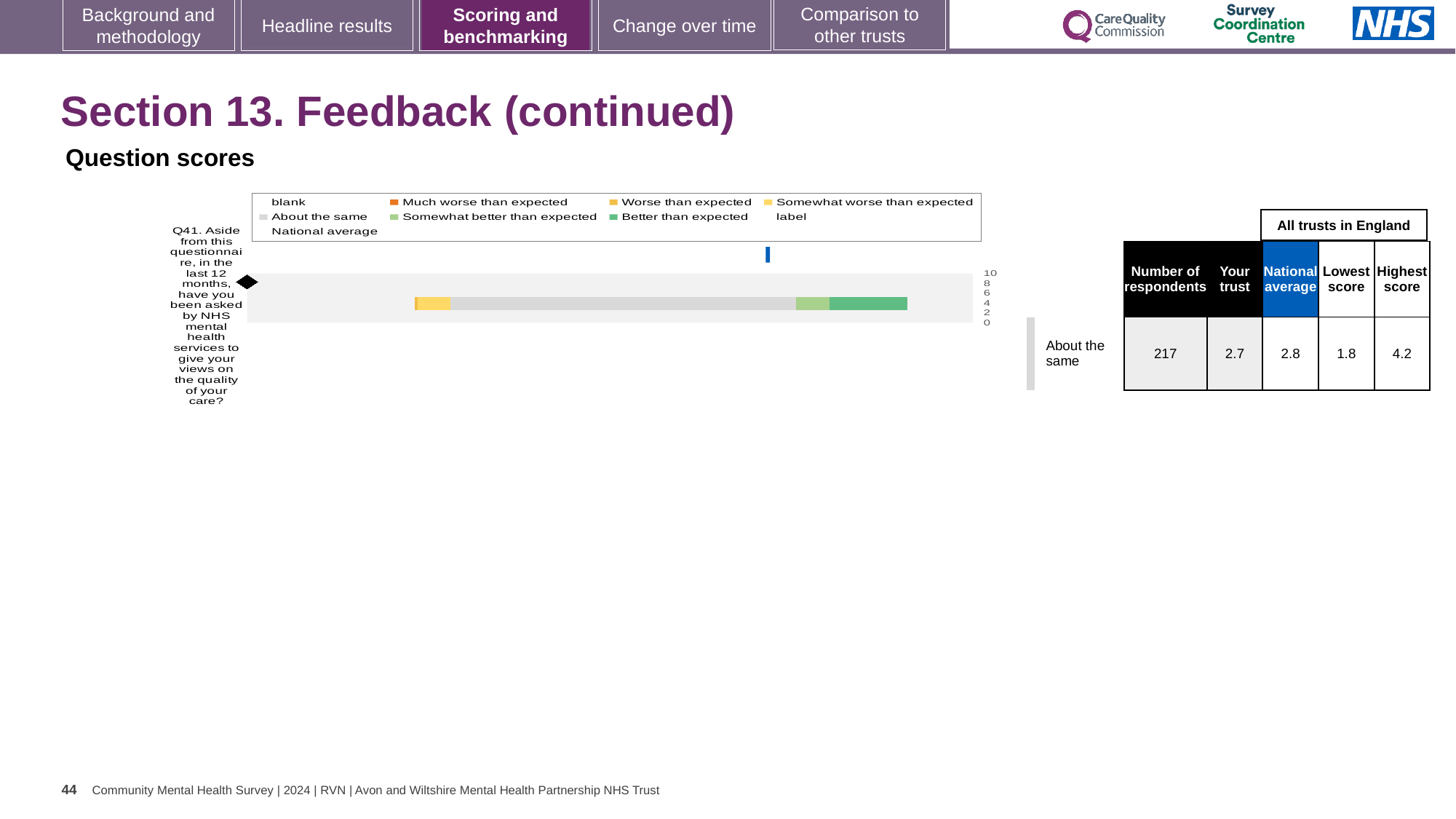
What is the national average score for Q41? 2.8 What kind of chart is shown on the slide? bar chart How many survey questions are plotted in the chart? 1 What is the 'Your trust' score for Q41? 2.7 Which is larger for Q41, the 'Your trust' score or the national average? National average What benchmark category is the trust's Q41 score placed in? About the same Which question is plotted in the chart? Q41. Aside from this questionnaire, in the last 12 months, have you been asked by NHS mental health services to give your views on the quality of your care? What is the lowest score among all trusts in England for Q41? 1.8 What is the difference between the national average and the 'Your trust' score for Q41? 0.1 What is the difference between the highest and lowest scores among all trusts in England for Q41? 2.4 What is the highest score among all trusts in England for Q41? 4.2 What is the number of respondents for Q41? 217